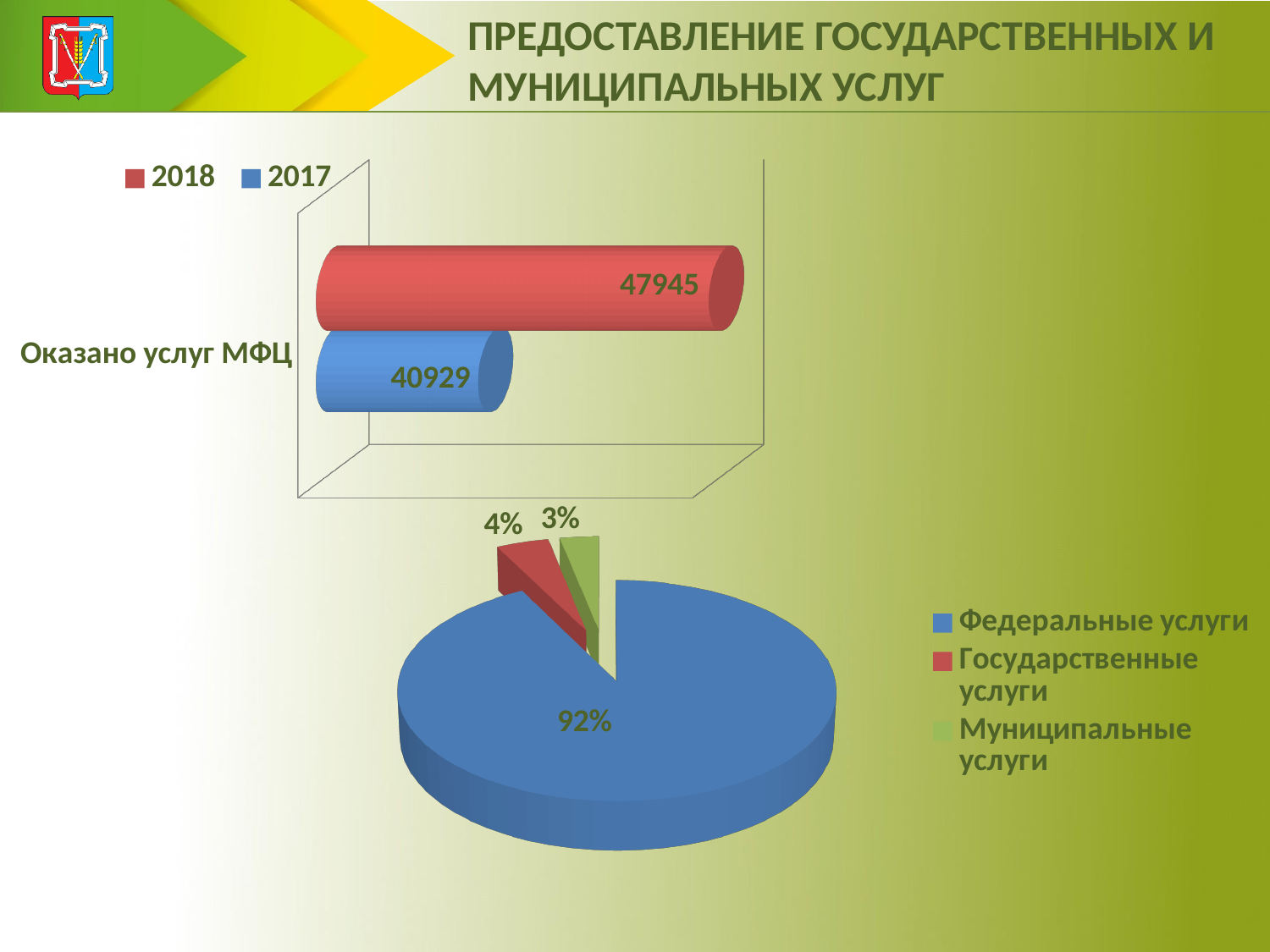
What kind of chart is the bottom chart on the slide? Pie chart In the top bar chart, what is the value for 2018 for Оказано услуг МФЦ? 47945 In the top bar chart, what is the value for 2017 for Оказано услуг МФЦ? 40929 In the bottom pie chart, what share do Федеральные услуги have? 92% In the top bar chart, which year has the higher value for Оказано услуг МФЦ, 2018 or 2017? 2018 How many series does the legend of the top bar chart list? 2 In the bottom pie chart, what share do Муниципальные услуги have? 3% How many slices does the bottom pie chart have? 3 In the bottom pie chart, which category has the smallest share? Муниципальные услуги In the top bar chart, what is the difference between the 2018 and 2017 values for Оказано услуг МФЦ? 7016 What kind of chart is the top chart on the slide? Bar chart In the bottom pie chart, what share do Государственные услуги have? 4%